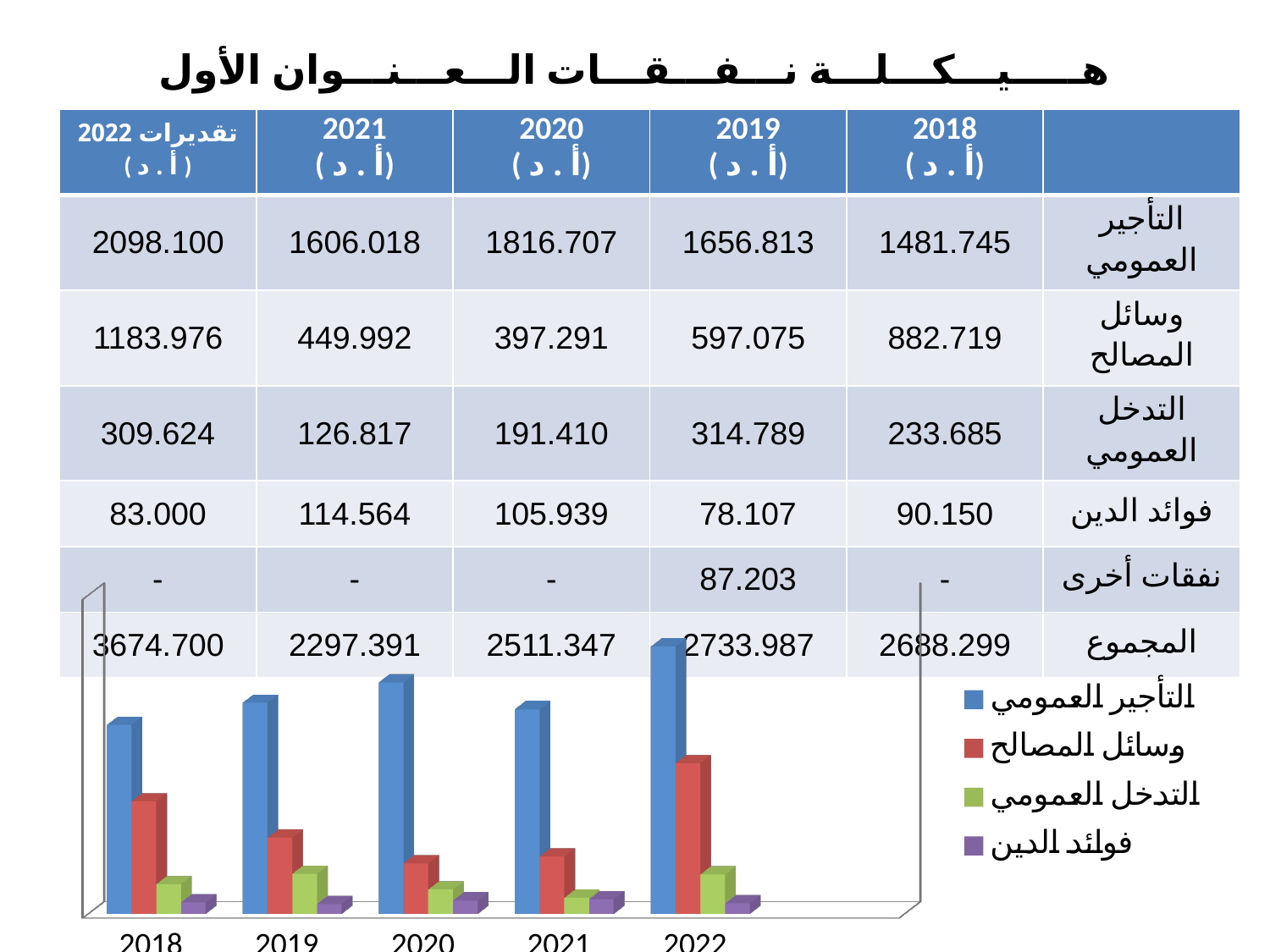
According to the table, what is the value of التأجير العمومي for تقديرات 2022? 2098.100 Which is larger for وسائل المصالح: the bar for 2018 or the bar for 2019? 2018 How many series does the chart legend list? 4 Which is larger for التأجير العمومي: the bar for 2019 or the bar for 2020? 2020 Which series is shown in blue in the chart? التأجير العمومي In which year is the bar for وسائل المصالح the tallest? 2022 What kind of chart is shown at the bottom of the slide? bar chart How many years (categories) are shown along the x axis of the chart? 5 In which year is the bar for التأجير العمومي the shortest? 2018 Which series is shown in purple in the chart? فوائد الدين Do the bars for وسائل المصالح rise or fall from 2018 to 2020? fall In which year is the bar for التأجير العمومي the tallest? 2022